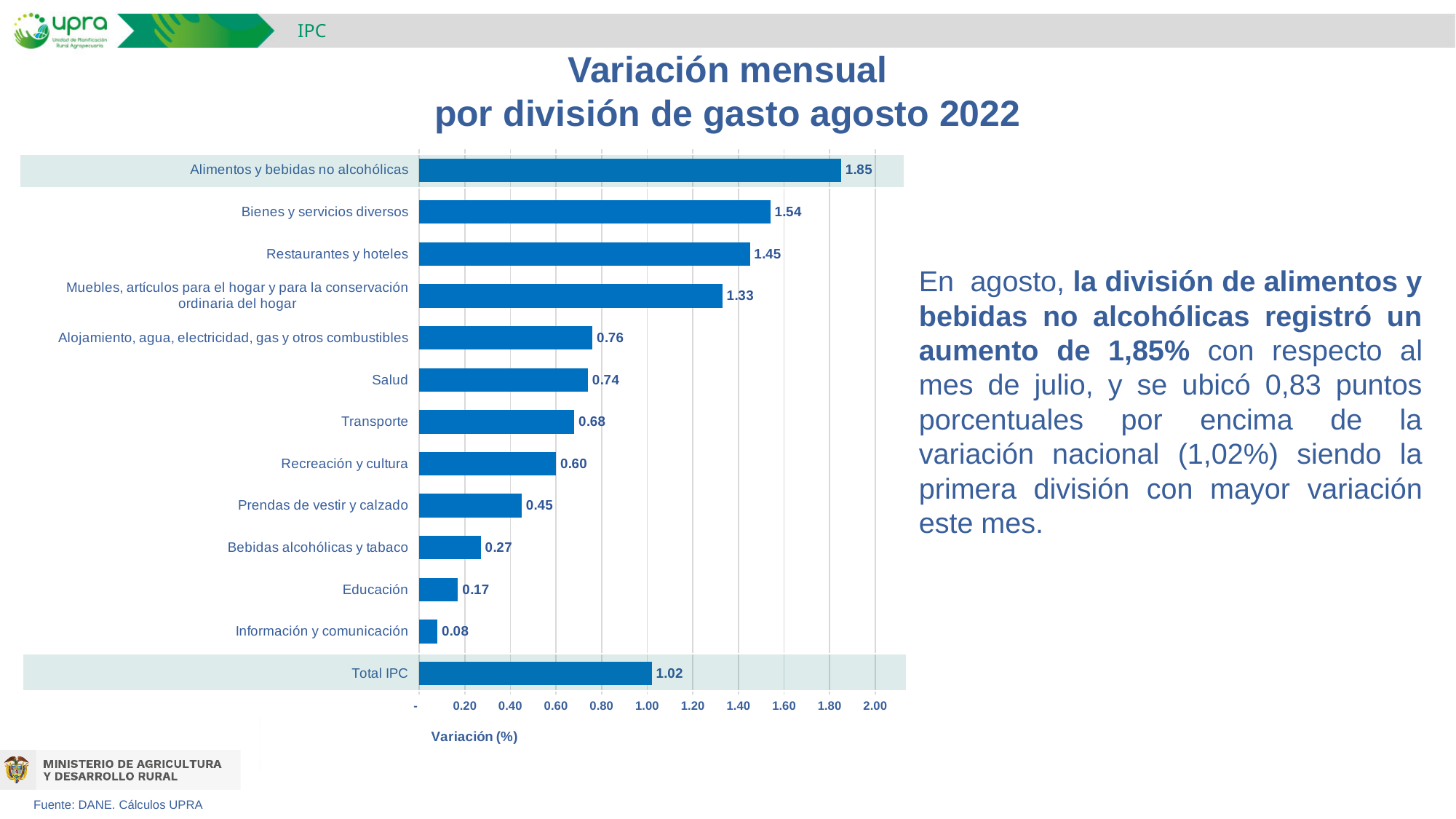
Which is larger, the value for Transporte or the value for Recreación y cultura? Transporte What is the title of the chart? Variación mensual por división de gasto agosto 2022 What is the value for Salud? 0.74 What is the label of the horizontal axis? Variación (%) What is the difference between the values for Alimentos y bebidas no alcohólicas and Total IPC? 0.83 How many categories are shown in the chart? 13 What is the value for Alimentos y bebidas no alcohólicas? 1.85 Is the value for Bienes y servicios diversos greater or less than 1.40? greater Which category has the lowest value? Información y comunicación Which category has the highest value? Alimentos y bebidas no alcohólicas What kind of chart is shown on the slide? Bar chart What is the value for Total IPC? 1.02